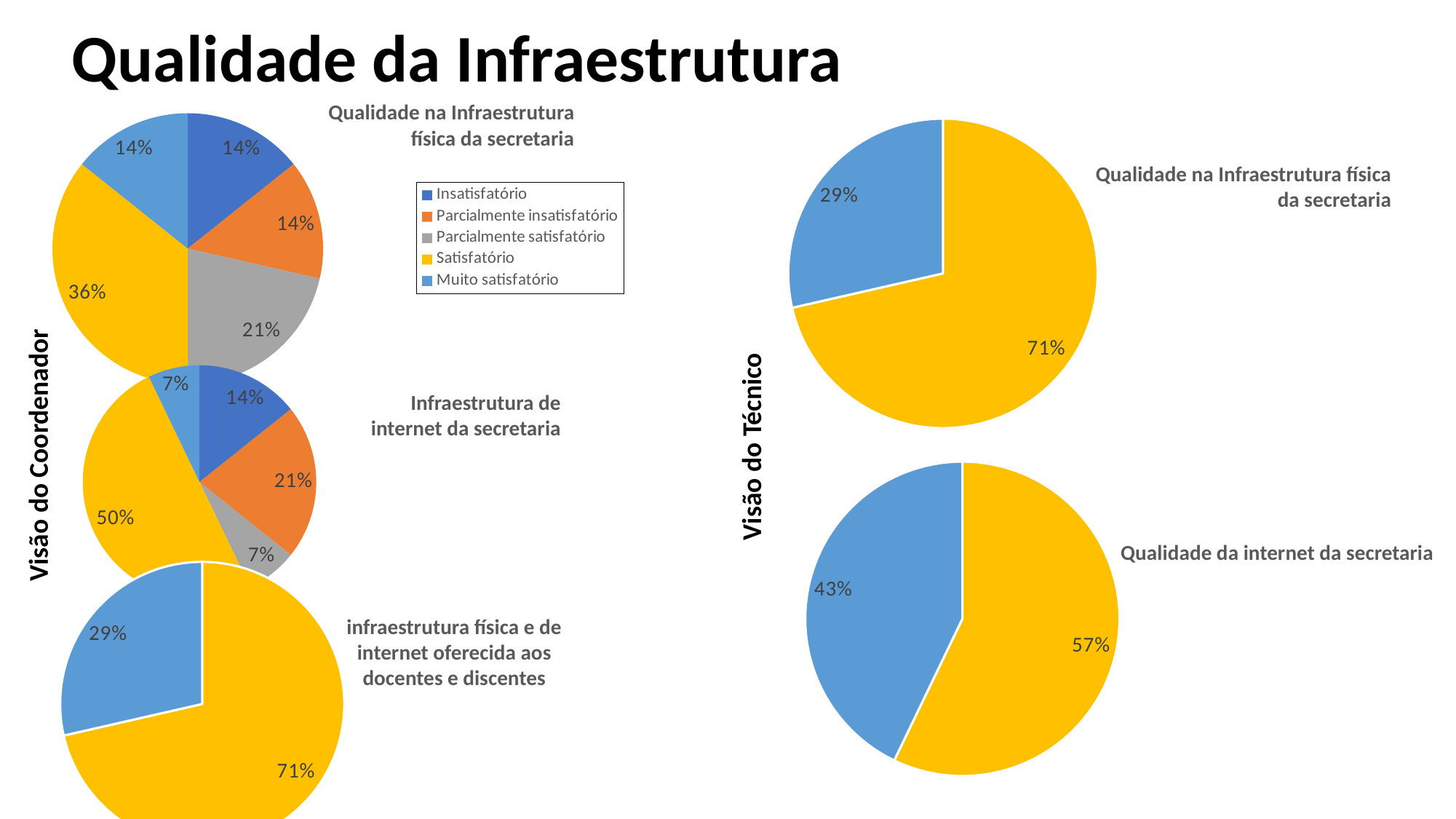
In the 'Visão do Técnico' chart 'Qualidade na Infraestrutura física da secretaria', what share is Satisfatório? 71% In the 'Visão do Coordenador' chart 'infraestrutura física e de internet oferecida aos docentes e discentes', what share is Muito satisfatório? 29% How many categories does the legend list? 5 How many slices does the 'Visão do Coordenador' chart 'Qualidade na Infraestrutura física da secretaria' have? 5 In the 'Visão do Coordenador' chart 'Infraestrutura de internet da secretaria', what share is Parcialmente insatisfatório? 21% In the 'Visão do Coordenador' chart 'Qualidade na Infraestrutura física da secretaria', what share is Satisfatório? 36% In the 'Visão do Coordenador' chart 'Infraestrutura de internet da secretaria', which category has the largest share? Satisfatório In the 'Visão do Coordenador' chart 'Infraestrutura de internet da secretaria', what is the difference between the Satisfatório and Insatisfatório shares? 36% In the 'Visão do Coordenador' chart 'Qualidade na Infraestrutura física da secretaria', what share is Parcialmente satisfatório? 21% In the 'Visão do Técnico' chart 'Qualidade da internet da secretaria', what is the difference between the Satisfatório and Muito satisfatório shares? 14% What type of chart is used on this slide? Pie chart In the 'Visão do Técnico' chart 'Qualidade da internet da secretaria', which is larger, Satisfatório or Muito satisfatório? Satisfatório